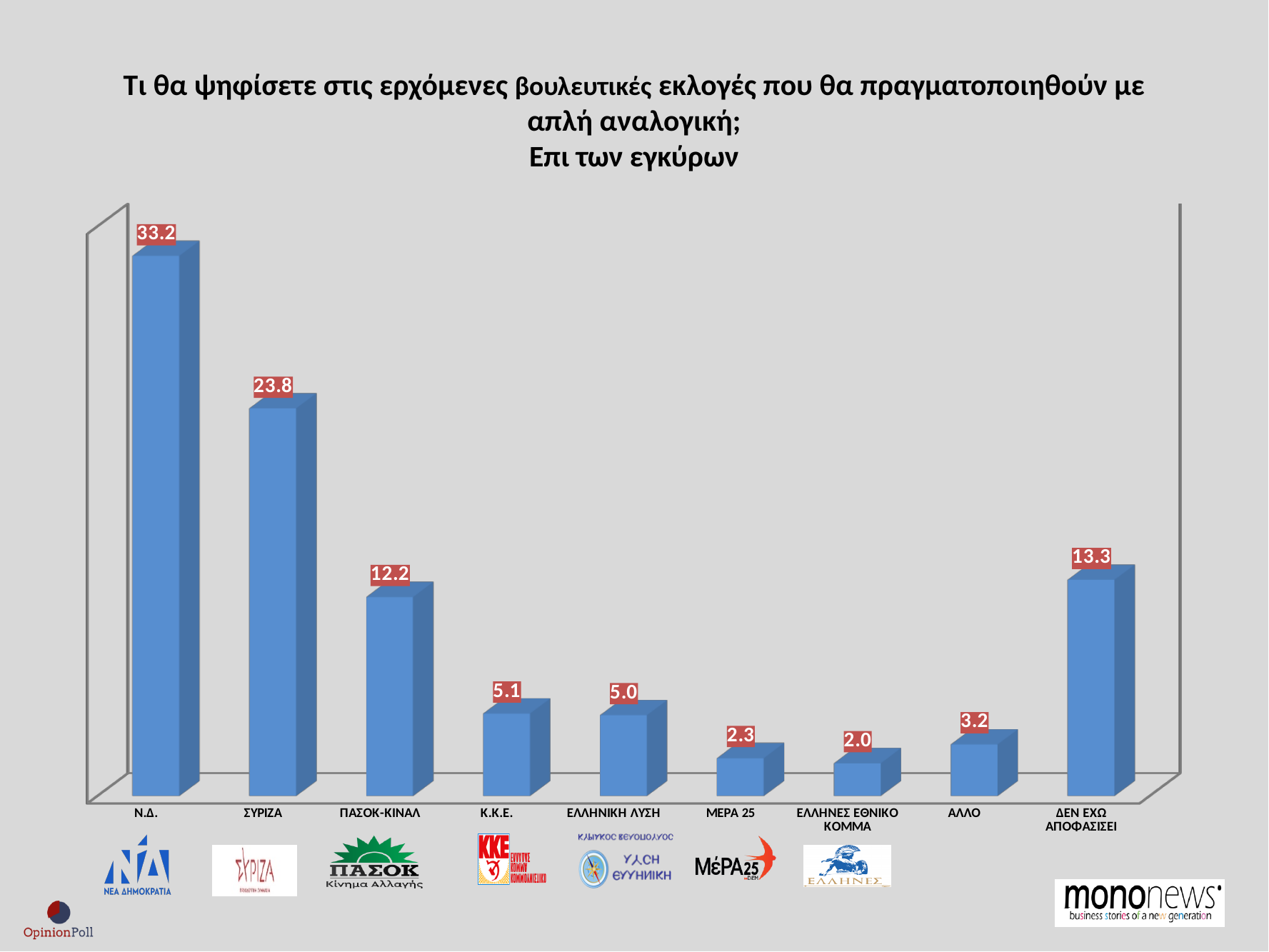
What kind of chart is shown on the slide? Bar chart Which category has the lowest value? ΕΛΛΗΝΕΣ ΕΘΝΙΚΟ ΚΟΜΜΑ What is the difference between the values for ΠΑΣΟΚ-ΚΙΝΑΛ and Κ.Κ.Ε.? 7.1 How many categories are shown on the x axis? 9 What is the value for ΕΛΛΗΝΙΚΗ ΛΥΣΗ? 5.0 What colour are the bars in the chart? Blue Which category has the highest value? Ν.Δ. What is the value for Ν.Δ.? 33.2 Which is larger, the value for ΜΕΡΑ 25 or the value for ΑΛΛΟ? ΑΛΛΟ What is the difference between the values for Ν.Δ. and ΣΥΡΙΖΑ? 9.4 What is the value for ΔΕΝ ΕΧΩ ΑΠΟΦΑΣΙΣΕΙ? 13.3 What is the value for ΣΥΡΙΖΑ? 23.8